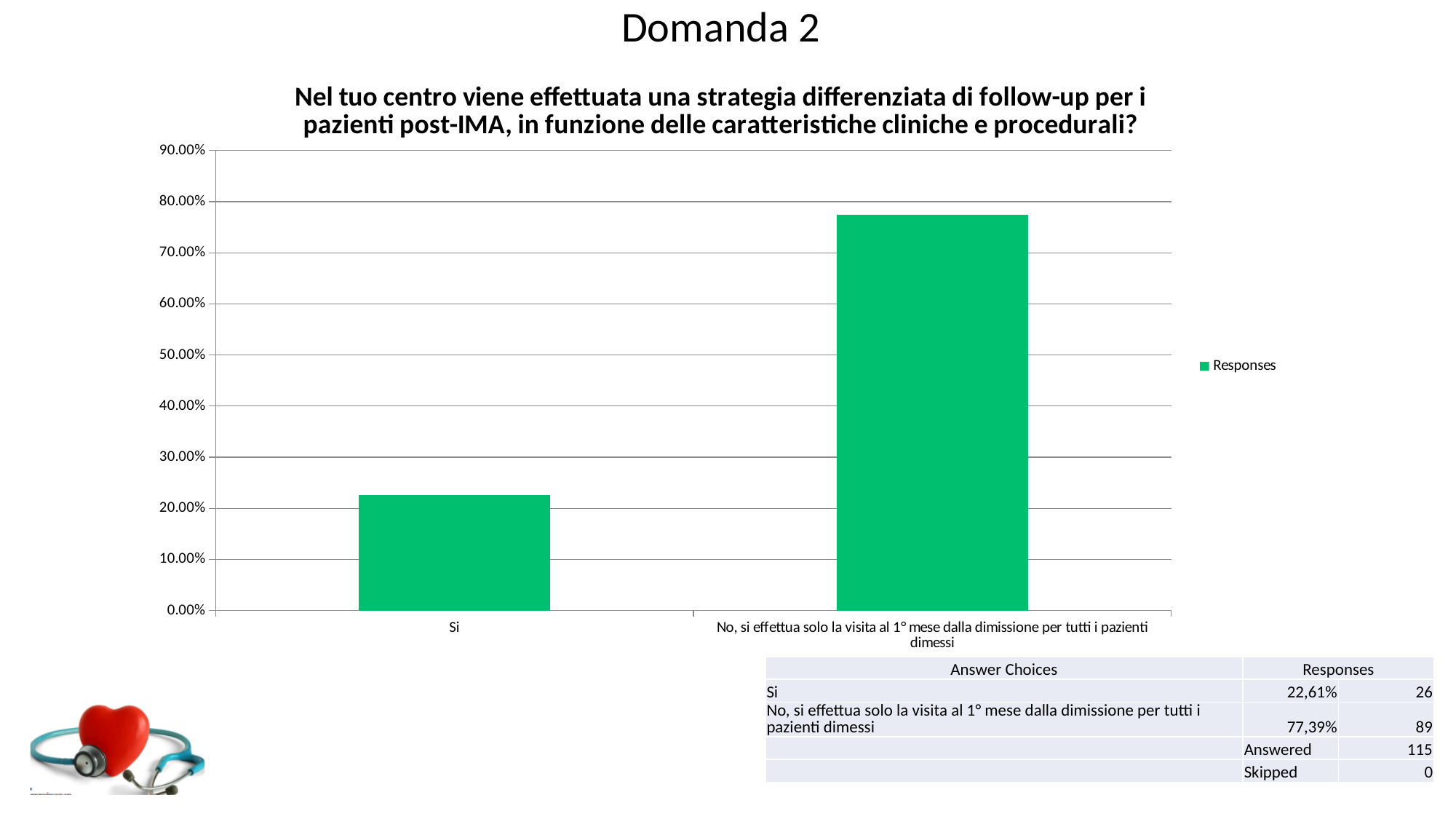
What is the highest value shown on the chart's y axis? 90.00% Which category has the highest value in the chart? No, si effettua solo la visita al 1° mese dalla dimissione per tutti i pazienti dimessi How many categories are plotted on the x axis of the chart? 2 How many series does the chart legend list? 1 Which is larger: the bar for "Si" or the bar for "No, si effettua solo la visita al 1° mese dalla dimissione per tutti i pazienti dimessi"? No, si effettua solo la visita al 1° mese dalla dimissione per tutti i pazienti dimessi What is the name of the series shown in the chart legend? Responses What kind of chart is shown on the slide? bar chart What is the response percentage for "No, si effettua solo la visita al 1° mese dalla dimissione per tutti i pazienti dimessi" according to the table on the slide? 77,39% Which category has the lowest value in the chart? Si Is the value of the bar for "Si" greater or less than 30.00%? less Is the value of the bar for "No, si effettua solo la visita al 1° mese dalla dimissione per tutti i pazienti dimessi" greater or less than 70.00%? greater What is the response percentage for "Si" according to the table on the slide? 22,61%